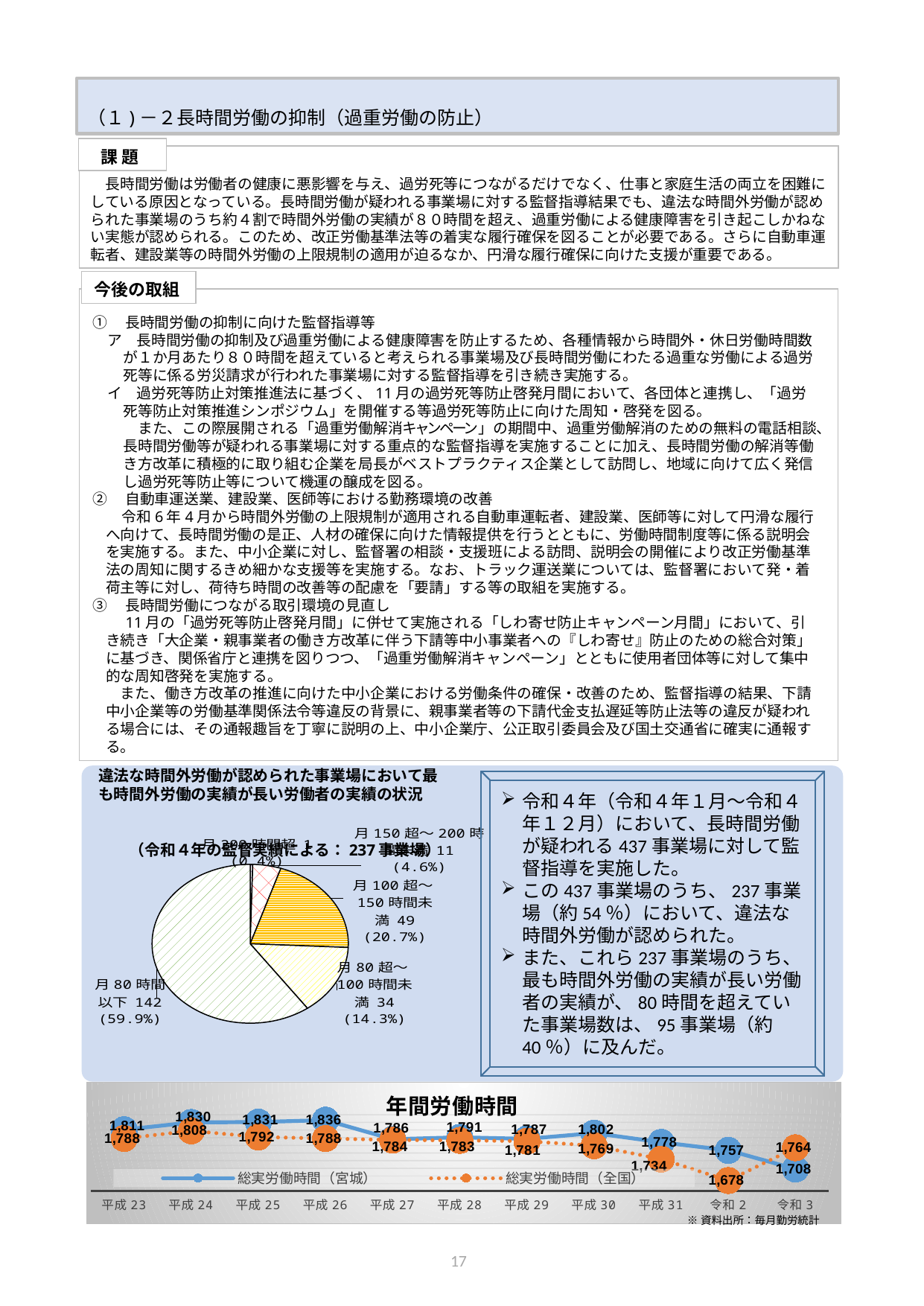
In the 年間労働時間 chart, what is the value for 総実労働時間（全国） in 令和2? 1,678 What kind of chart is the 年間労働時間 chart? line chart In the pie chart, what share does the 月100超〜150時間未満 slice represent? 20.7% In the pie chart, how many establishments are in the 月80時間以下 category? 142 In the 年間労働時間 chart, how many series does the legend list? 2 In the pie chart, what share does the 月80時間以下 slice represent? 59.9% In the pie chart, which is larger: the 月80超〜100時間未満 slice or the 月100超〜150時間未満 slice? 月100超〜150時間未満 In the 年間労働時間 chart, what is the value for 総実労働時間（宮城） in 平成26? 1,836 In the pie chart, which category has the smallest slice? 月200時間超 In the pie chart, how many categories are shown? 5 In the 年間労働時間 chart, what is the difference between 宮城 and 全国 in 令和2? 79 In the 年間労働時間 chart, in which year is the 総実労働時間（全国） value lowest? 令和2